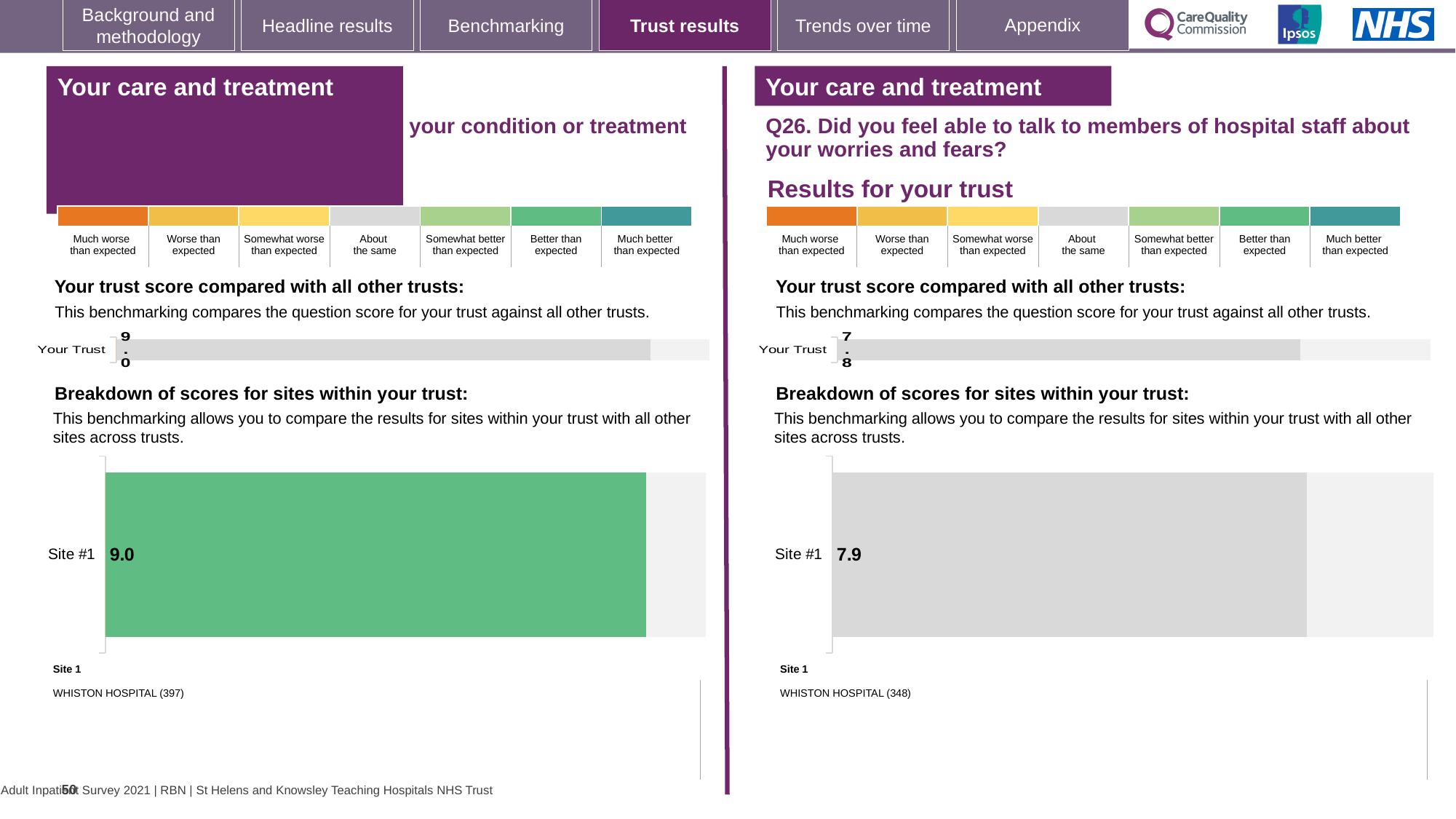
On the left-hand side of the slide, what is the value shown for 'Your Trust' in the trust score comparison bar? 9.0 On the right-hand side of the slide (Q26), is the Site #1 score greater or less than the 'Your Trust' score? Greater What is the difference between the 'Your Trust' score on the left-hand side of the slide and the 'Your Trust' score on the right-hand side (Q26)? 1.2 What type of chart is used to show the breakdown of scores for sites within your trust on the right-hand side of the slide? Bar chart On the right-hand side of the slide (Q26), what is the value shown for 'Your Trust' in the trust score comparison bar? 7.8 Which Site #1 score is larger: the one on the left-hand side of the slide or the one on the right-hand side (Q26)? The left-hand side (9.0) On the left-hand side of the slide, what colour is the Site #1 bar in the breakdown of scores chart? Green On the left-hand side of the slide, what is the score shown for Site #1 in the breakdown of scores for sites within your trust? 9.0 On the right-hand side of the slide (Q26), what is the score shown for Site #1 in the breakdown of scores for sites within your trust? 7.9 What is the difference between the Site #1 score on the left-hand side of the slide and the Site #1 score on the right-hand side (Q26)? 1.1 How many sites are shown in the breakdown of scores chart on the left-hand side of the slide? 1 On the right-hand side of the slide (Q26), which site name is listed as Site 1 below the chart? WHISTON HOSPITAL (348)